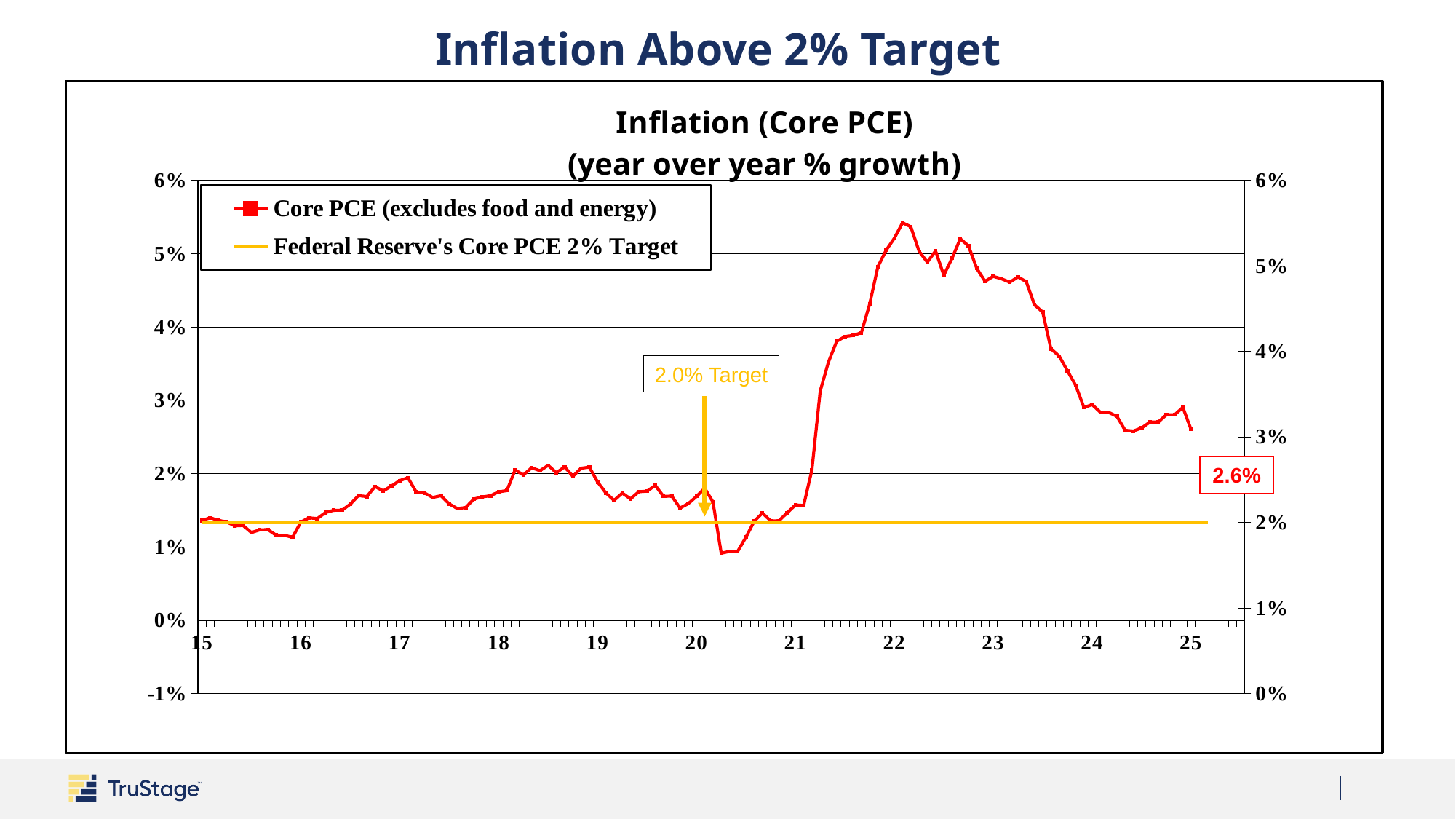
What target level does the Federal Reserve's Core PCE target line represent? 2.0% How many series does the legend list? 2 In which year on the x axis does the Core PCE line reach its lowest point? 20 Is the latest Core PCE value (2.6%) greater or less than the 2.0% target? greater What is the most recent Core PCE value labeled on the chart? 2.6% Which is larger, the Core PCE value in 2022 or in 2025? 2022 What colour is the Federal Reserve's Core PCE 2% Target line? yellow In which year on the x axis does the Core PCE line reach its highest point? 22 What is the title of the chart? Inflation (Core PCE) (year over year % growth) Is the peak Core PCE value around 2022 greater or less than 5%? greater What type of chart is shown on the slide? line chart Does the Core PCE line rise or fall between 2022 and 2024? fall